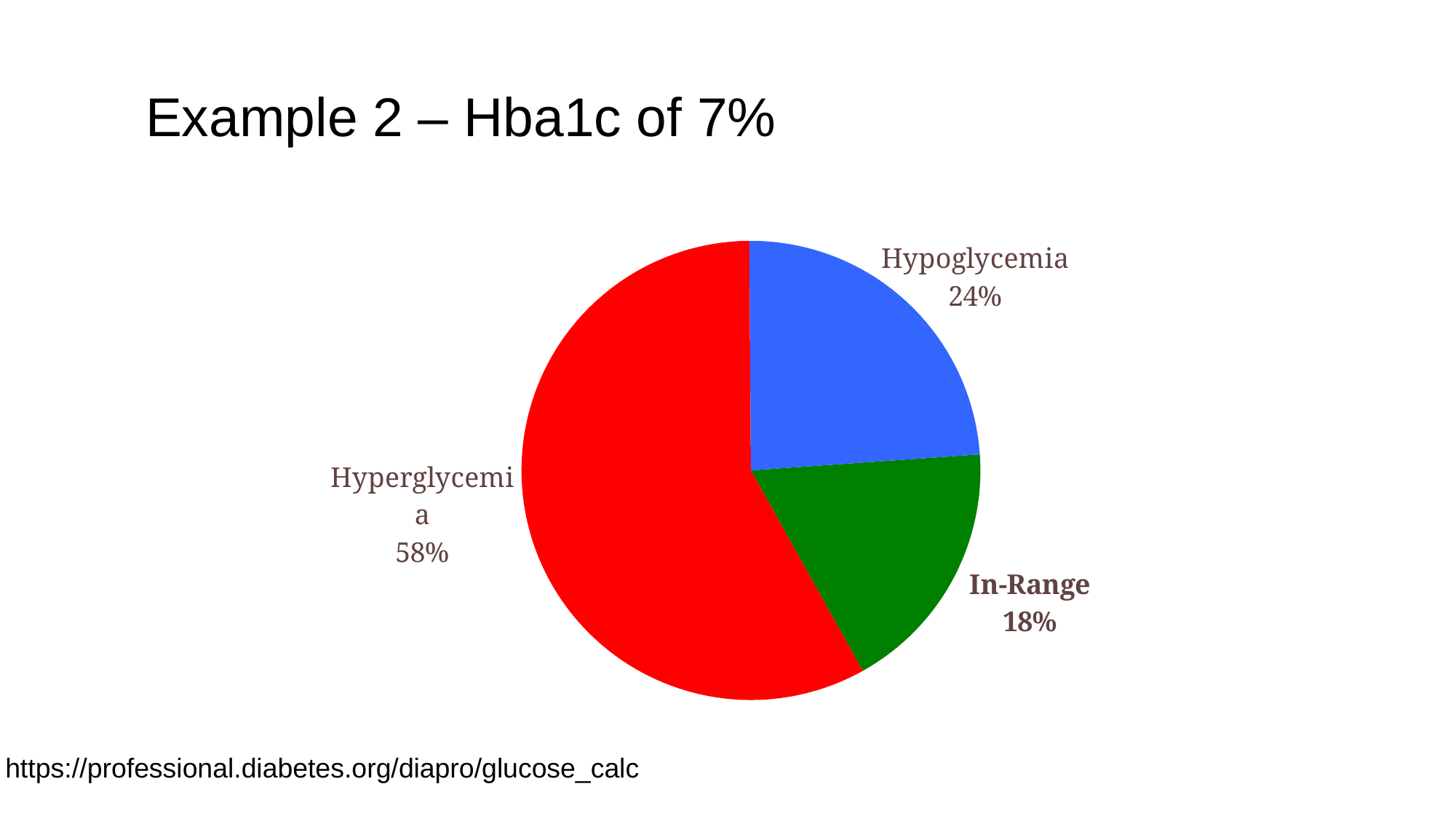
What is the difference in percentage points between Hypoglycemia and In-Range? 6 Which slice of the pie is the smallest? In-Range What colour is the In-Range slice? green What percentage of the pie is Hyperglycemia? 58% Which slice of the pie is the largest? Hyperglycemia What is the difference in percentage points between Hyperglycemia and Hypoglycemia? 34 What percentage of the pie is Hypoglycemia? 24% How many slices does the pie chart have? 3 What colour is the Hyperglycemia slice? red Which is larger, the Hypoglycemia slice or the In-Range slice? Hypoglycemia What percentage of the pie is In-Range? 18% What kind of chart is shown on the slide? pie chart